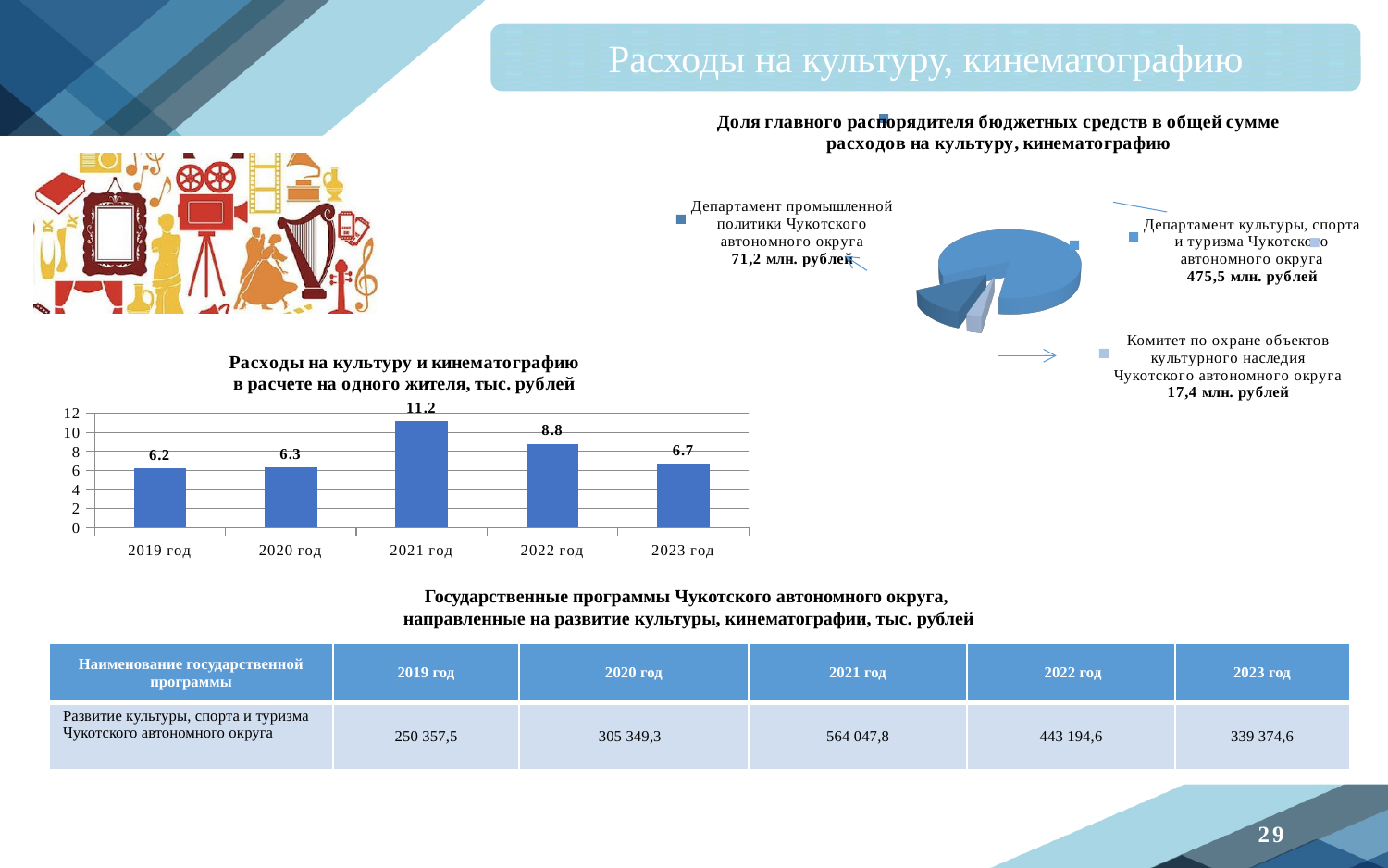
On the bar chart 'Расходы на культуру и кинематографию в расчете на одного жителя, тыс. рублей', how many years are shown on the x axis? 5 On the bar chart 'Расходы на культуру и кинематографию в расчете на одного жителя, тыс. рублей', what is the value for 2019 год? 6.2 What kind of chart is 'Расходы на культуру и кинематографию в расчете на одного жителя, тыс. рублей'? bar chart On the bar chart 'Расходы на культуру и кинематографию в расчете на одного жителя, тыс. рублей', do the values rise or fall from 2021 год to 2023 год? fall On the bar chart 'Расходы на культуру и кинематографию в расчете на одного жителя, тыс. рублей', which year has the highest value? 2021 год On the pie chart 'Доля главного распорядителя бюджетных средств в общей сумме расходов на культуру, кинематографию', what is the value for Департамент культуры, спорта и туризма Чукотского автономного округа? 475,5 млн. рублей On the bar chart 'Расходы на культуру и кинематографию в расчете на одного жителя, тыс. рублей', what is the value for 2021 год? 11.2 On the bar chart 'Расходы на культуру и кинематографию в расчете на одного жителя, тыс. рублей', what is the difference between the values for 2021 год and 2022 год? 2.4 On the bar chart 'Расходы на культуру и кинематографию в расчете на одного жителя, тыс. рублей', which year has the lowest value? 2019 год On the bar chart 'Расходы на культуру и кинематографию в расчете на одного жителя, тыс. рублей', which is larger: the value for 2022 год or 2023 год? 2022 год On the bar chart 'Расходы на культуру и кинематографию в расчете на одного жителя, тыс. рублей', what is the value for 2023 год? 6.7